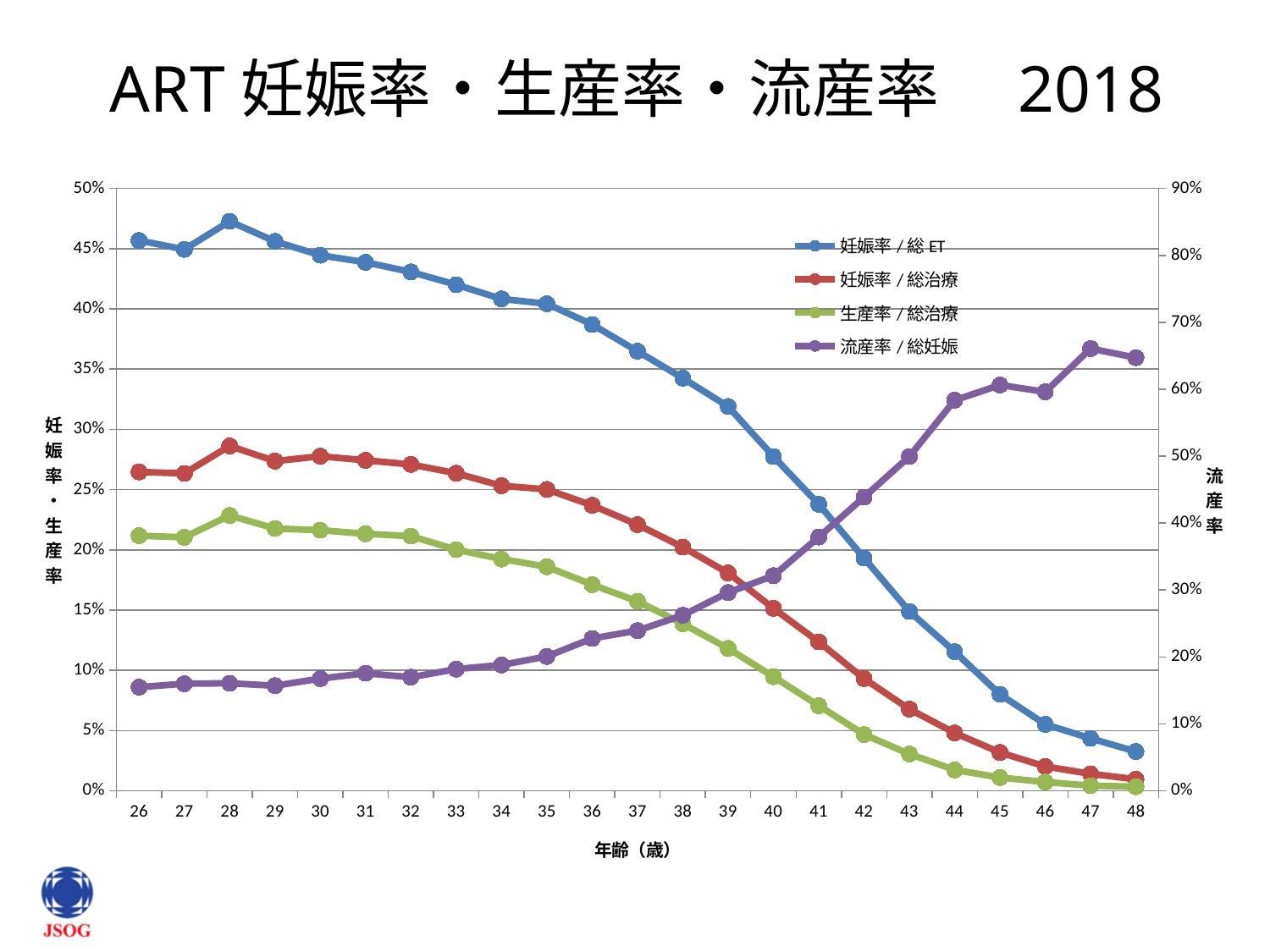
Does the 妊娠率 / 総治療 series generally rise or fall as age increases from 30 to 48? fall How many age categories are plotted along the x axis? 23 Does the 流産率 / 総妊娠 series generally rise or fall as age increases? rise At which age is the 妊娠率 / 総 ET series lowest? 48 At which age does the 妊娠率 / 総 ET series reach its highest value? 28 Is the value for 妊娠率 / 総治療 at age 42 greater or less than 10%? less Is the value for 流産率 / 総妊娠 at age 48 greater or less than 60%? greater What kind of chart is shown on the slide? line chart At age 30, which is larger: 妊娠率 / 総治療 or 生産率 / 総治療? 妊娠率 / 総治療 Is the value for 妊娠率 / 総 ET at age 28 greater or less than 45%? greater What is the title of the chart on the slide? ART 妊娠率・生産率・流産率 2018 How many series does the legend list? 4